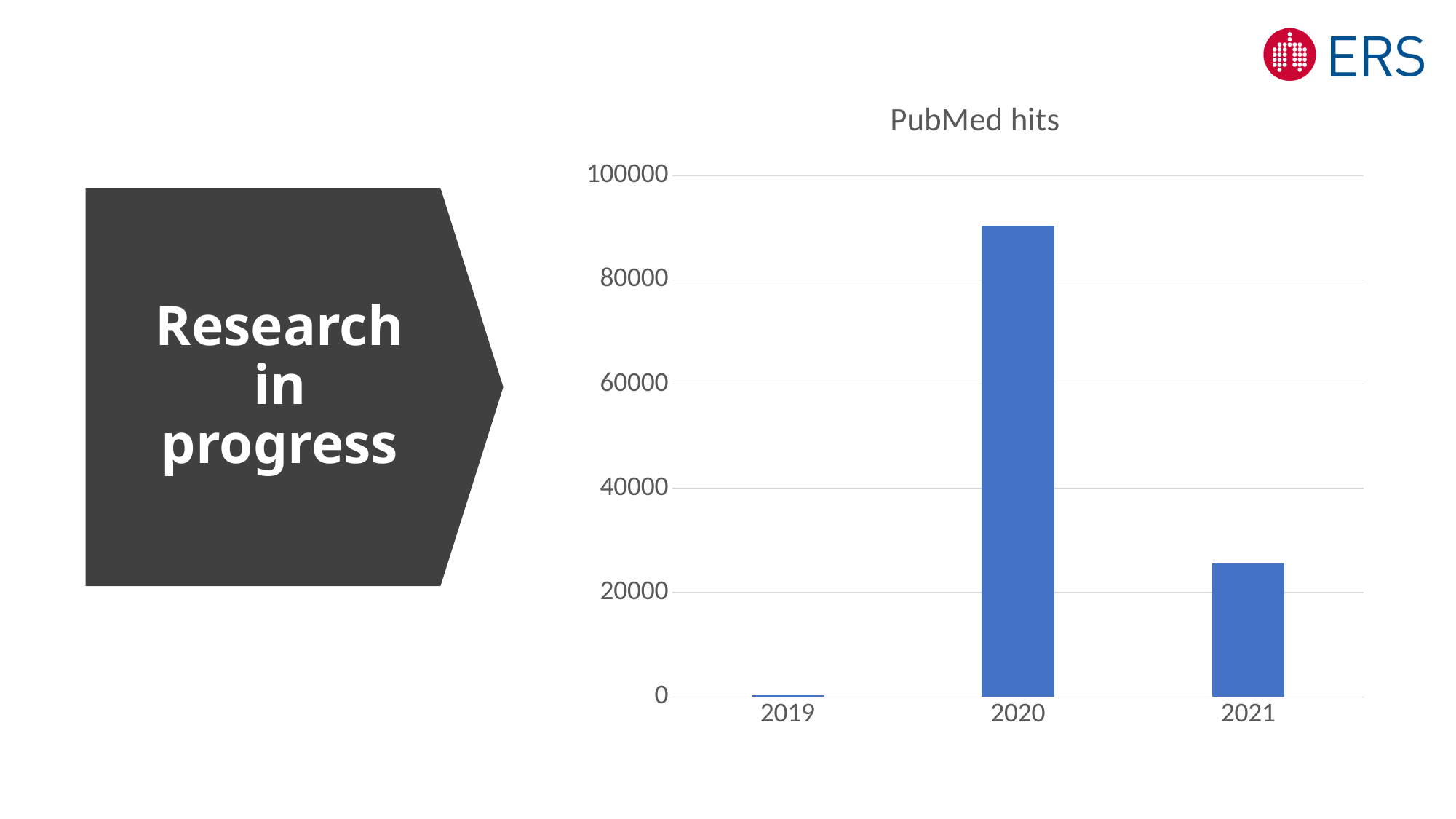
Which year has more PubMed hits, 2019 or 2021? 2021 Which year has the highest number of PubMed hits? 2020 How many years are shown on the x axis of the chart? 3 What is the highest value shown on the y axis of the chart? 100000 Is the value for 2021 greater or less than 40000? less Is the value for 2020 greater or less than 80000? greater Is the value for 2021 greater or less than 20000? greater What is the title of the chart? PubMed hits What kind of chart is shown on the slide? bar chart Which year has the lowest number of PubMed hits? 2019 Which year has more PubMed hits, 2020 or 2021? 2020